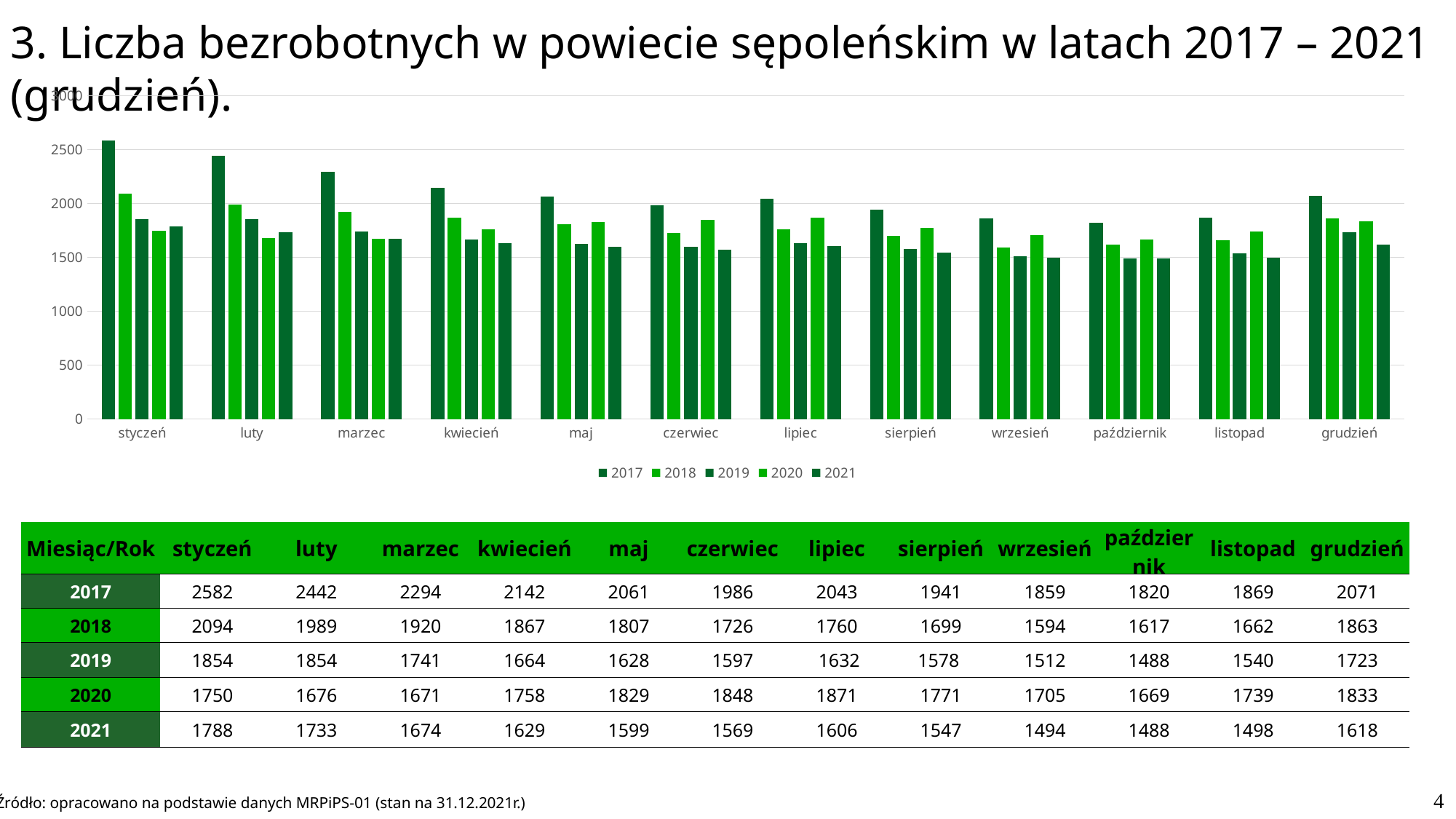
How many months (categories) are shown on the x axis of the chart? 12 What is the value for 2017 in styczeń? 2582 What is the difference between the 2017 and 2018 values in styczeń? 488 What is the value for 2021 in grudzień? 1618 How many series does the chart legend list? 5 What kind of chart is shown on the slide? bar chart What is the value for 2020 in lipiec? 1871 Which is larger in maj, the value for 2020 or the value for 2021? 2020 In which month is the 2017 value the highest? styczeń Is the value for 2017 in luty greater or less than 2000? greater Do the 2017 values rise or fall from styczeń to czerwiec? fall In which month is the 2017 value the lowest? październik